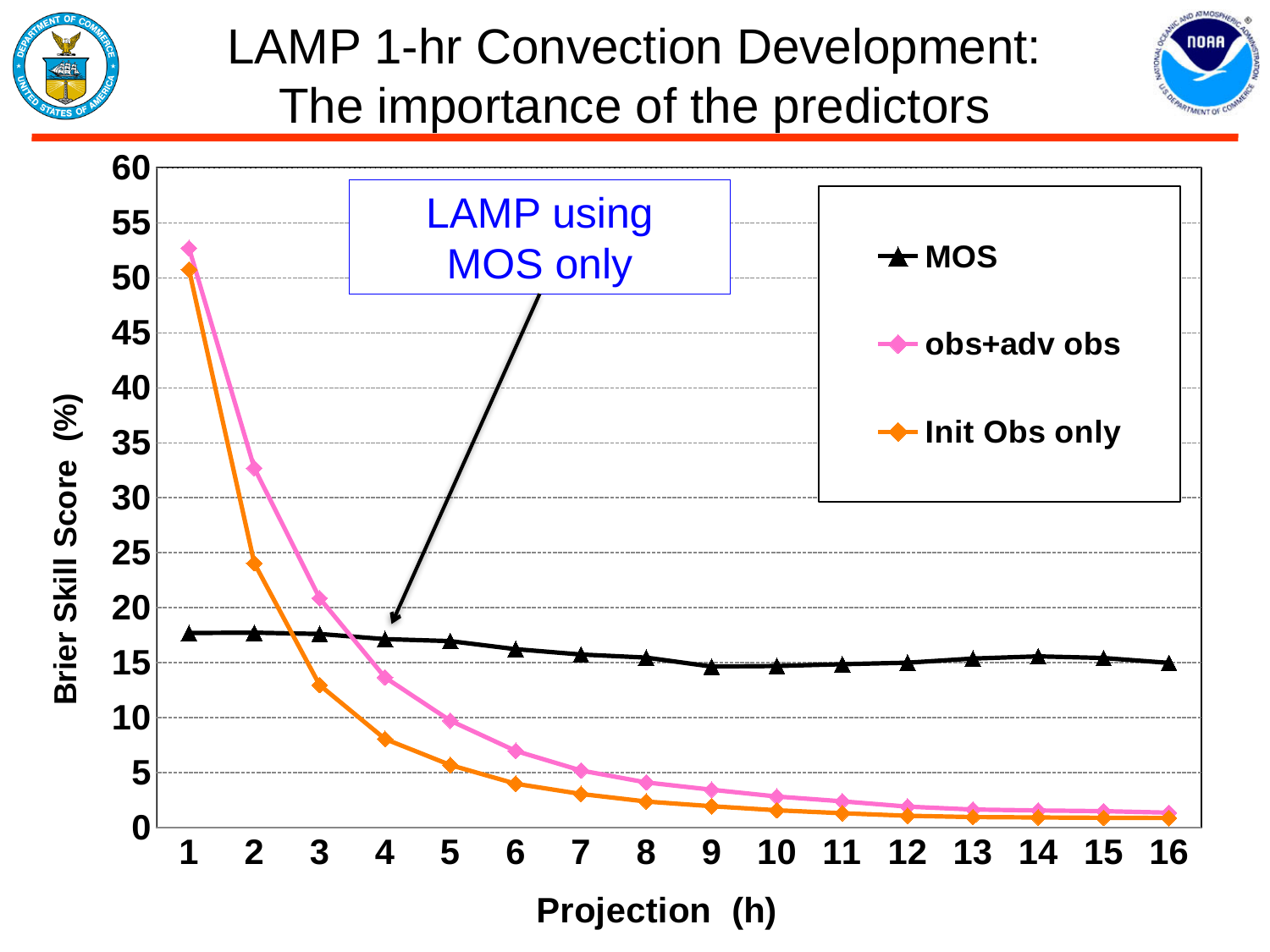
At projection 2, which is larger: obs+adv obs or MOS? obs+adv obs How many projection hours are plotted along the x axis? 16 Is the value for Init Obs only at projection 3 greater or less than 15? less How many series does the legend list? 3 Does the obs+adv obs series rise or fall as the projection hour increases? fall At projection 5, which is larger: MOS or Init Obs only? MOS What kind of chart is shown on the slide? line chart Which series has the lowest value at projection 4? Init Obs only Which series has the highest value at projection 10? MOS Is the value for MOS at projection 1 greater or less than 20? less Is the value for obs+adv obs at projection 1 greater or less than 50? greater